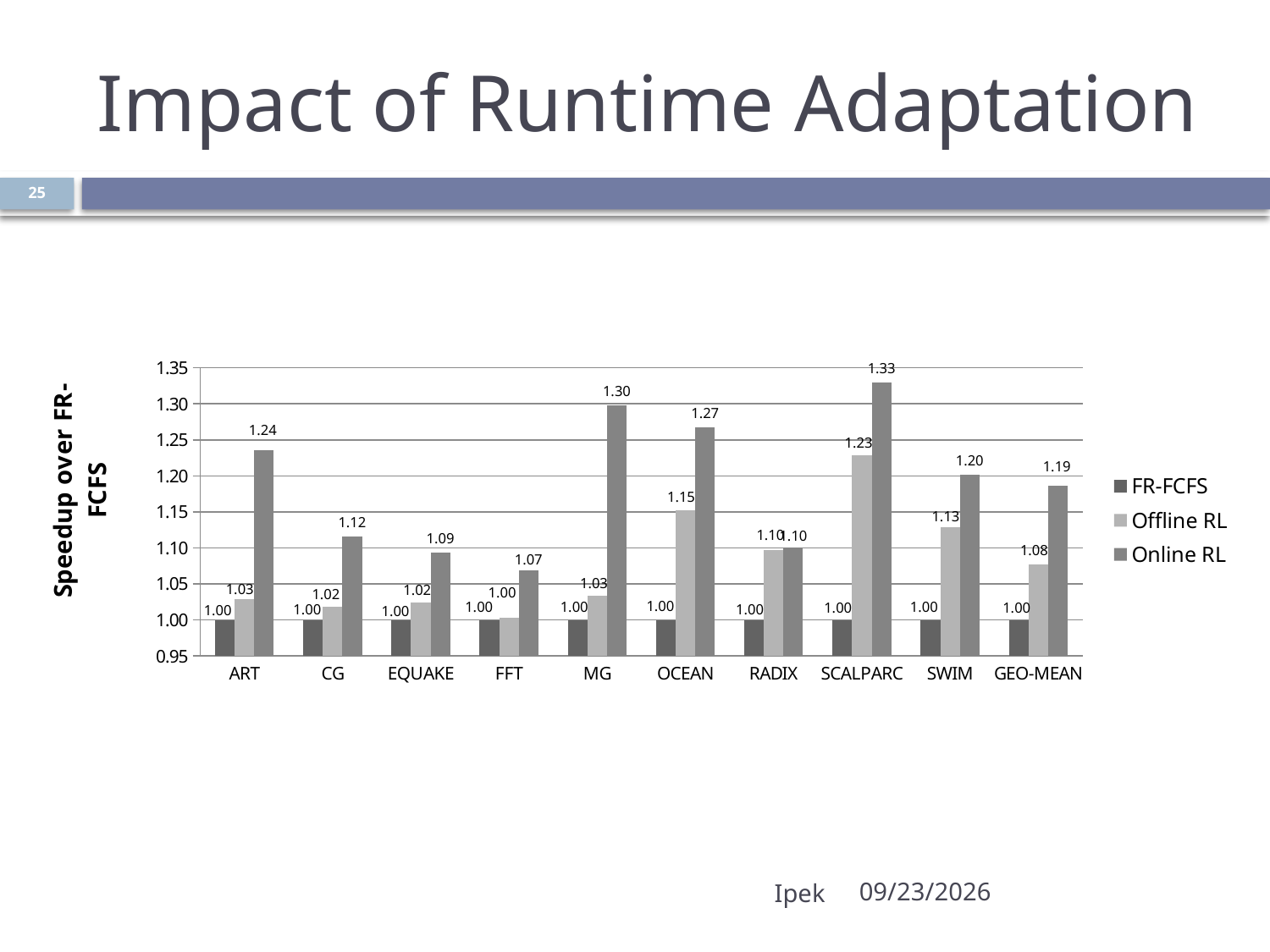
What kind of chart is shown on the slide? bar chart What is the label of the y axis? Speedup over FR-FCFS What is the Offline RL speedup for OCEAN? 1.15 What is the difference between the Online RL and Offline RL values for MG? 0.27 How many categories are shown on the x axis? 10 What is the Online RL speedup for SCALPARC? 1.33 Which category has the lowest Offline RL speedup? FFT Is the Online RL value for OCEAN greater or less than 1.25? greater Which is larger, the Online RL value for ART or the Online RL value for CG? ART How many series does the legend list? 3 Which category has the highest Online RL speedup? SCALPARC What is the Online RL value for GEO-MEAN? 1.19